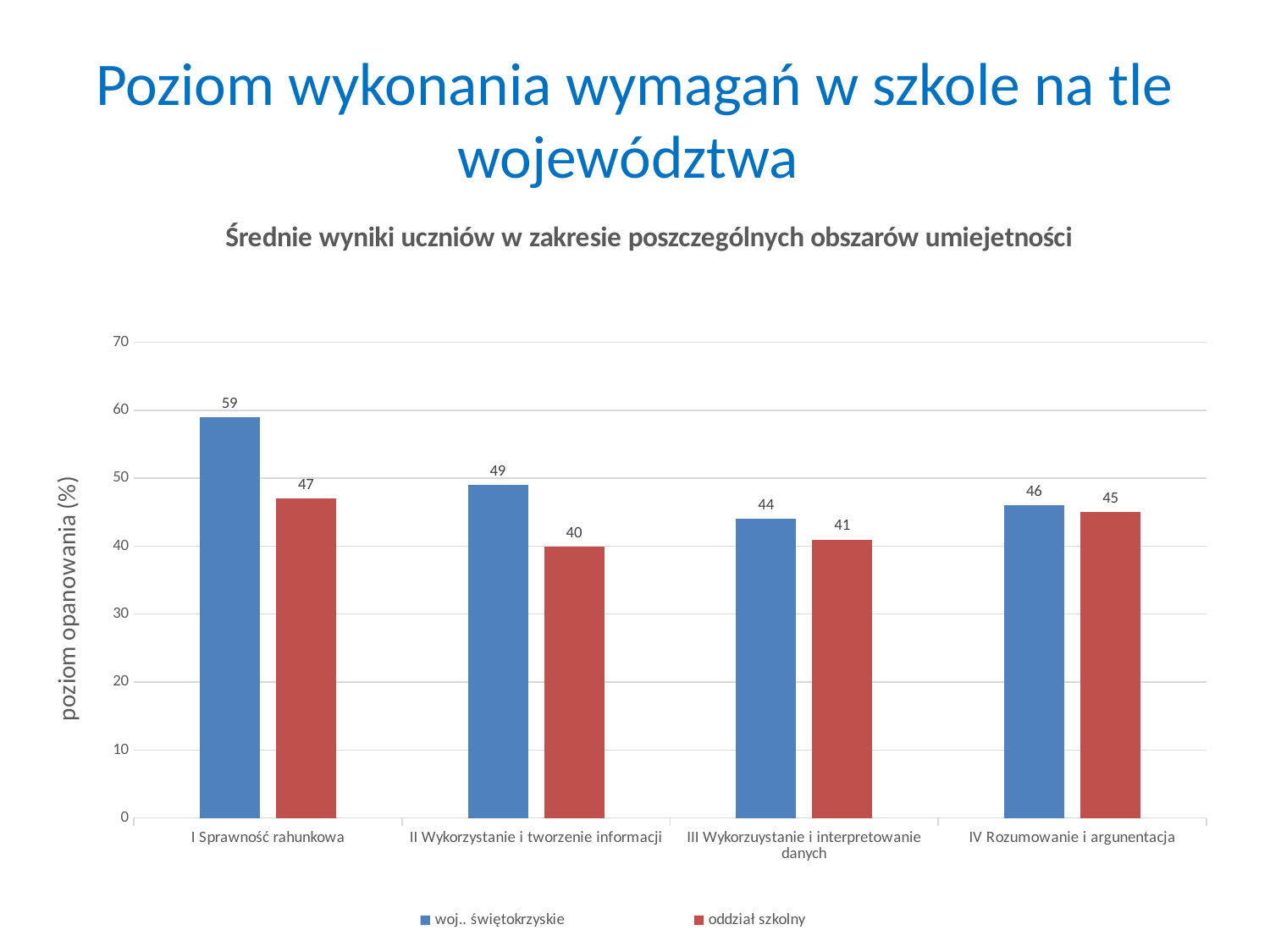
Which series has the larger value in the category III Wykorzuystanie i interpretowanie danych? woj.. świętokrzyskie What is the difference between woj.. świętokrzyskie and oddział szkolny in the category I Sprawność rahunkowa? 12 Which category has the highest value for woj.. świętokrzyskie? I Sprawność rahunkowa What is the label of the y axis? poziom opanowania (%) Is the value for oddział szkolny in the category II Wykorzystanie i tworzenie informacji greater or less than 50? less What kind of chart is shown on the slide? bar chart What is the value for oddział szkolny in the category IV Rozumowanie i argunentacja? 45 What is the value for oddział szkolny in the category II Wykorzystanie i tworzenie informacji? 40 What is the value for woj.. świętokrzyskie in the category I Sprawność rahunkowa? 59 Which category has the lowest value for oddział szkolny? II Wykorzystanie i tworzenie informacji How many series does the legend list? 2 How many categories are shown on the x axis? 4